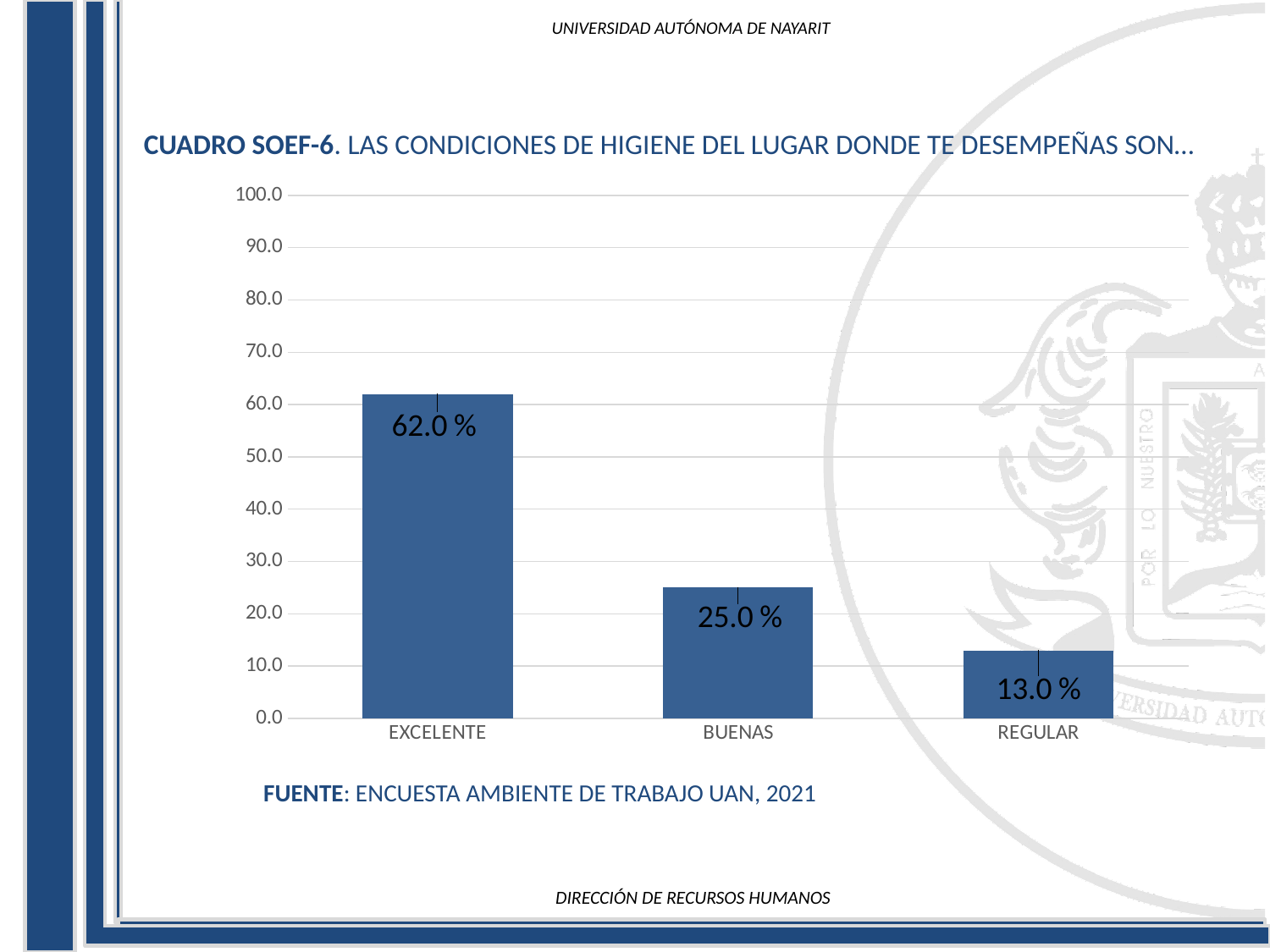
Which category has the highest value? EXCELENTE Which is larger, the value for BUENAS or the value for REGULAR? BUENAS What is the value for REGULAR? 13.0 % Is the value for EXCELENTE greater or less than 50.0? greater What is the difference between the values for BUENAS and REGULAR? 12.0 % What is the value for BUENAS? 25.0 % What is the difference between the values for EXCELENTE and BUENAS? 37.0 % Do the values rise or fall from left to right along the x axis? fall What kind of chart is shown on the slide? bar chart What is the value for EXCELENTE? 62.0 % Which category has the lowest value? REGULAR How many categories are shown on the x axis? 3